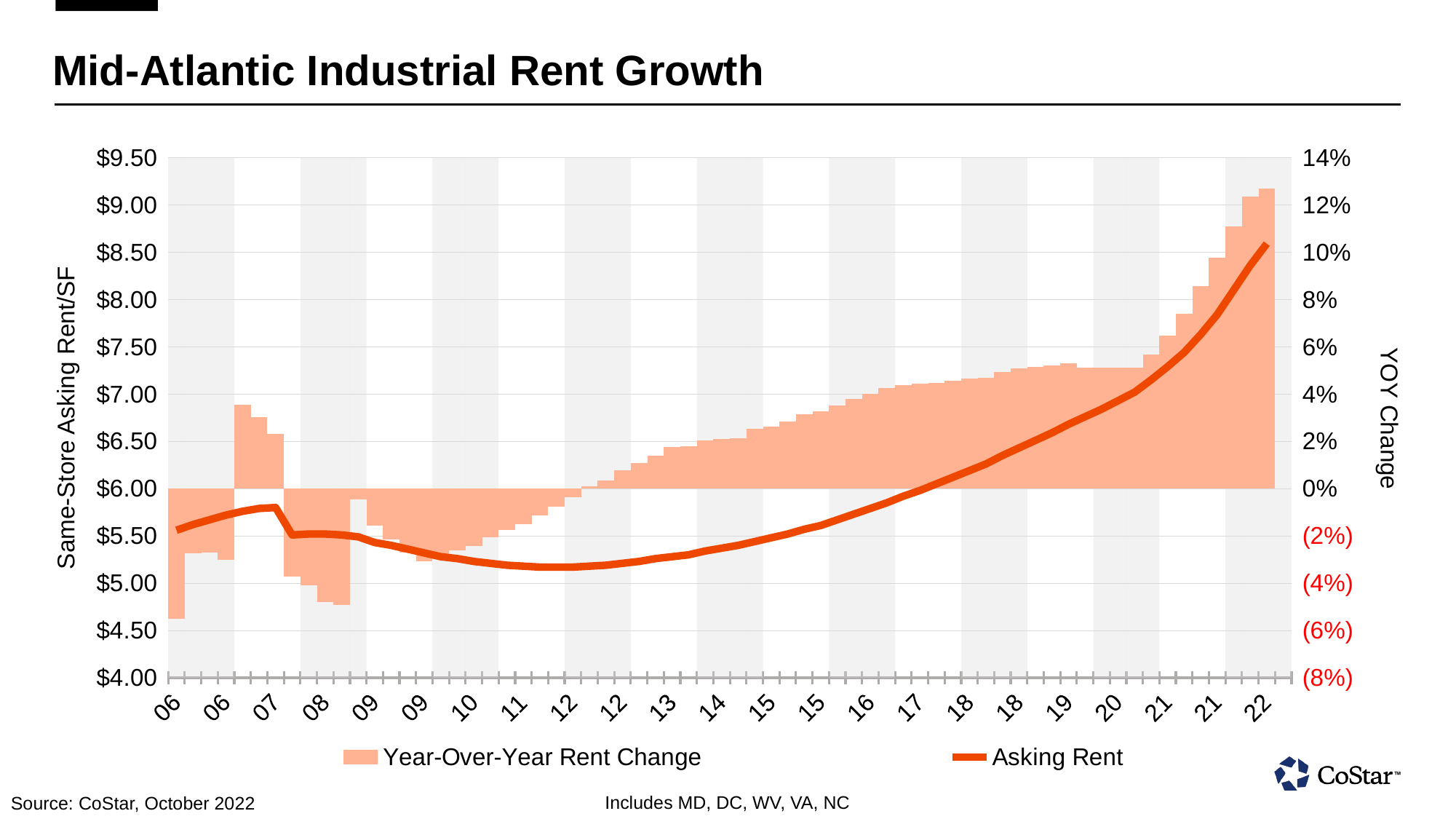
How many series does the legend list? 2 What kind of chart is shown on the slide? A combined bar and line chart Is the Year-Over-Year Rent Change at 19 greater or less than 4%? greater Is the Year-Over-Year Rent Change at 22 greater or less than 10%? greater Which is larger, the Asking Rent at 07 or the Asking Rent at 12? 07 What are the two series named in the legend? Year-Over-Year Rent Change and Asking Rent Does the Asking Rent line rise or fall between 12 and 22? rises Is the Asking Rent value at 12 greater or less than $5.50? less In which year on the x axis is the Year-Over-Year Rent Change highest? 22 What is the label on the left vertical axis? Same-Store Asking Rent/SF